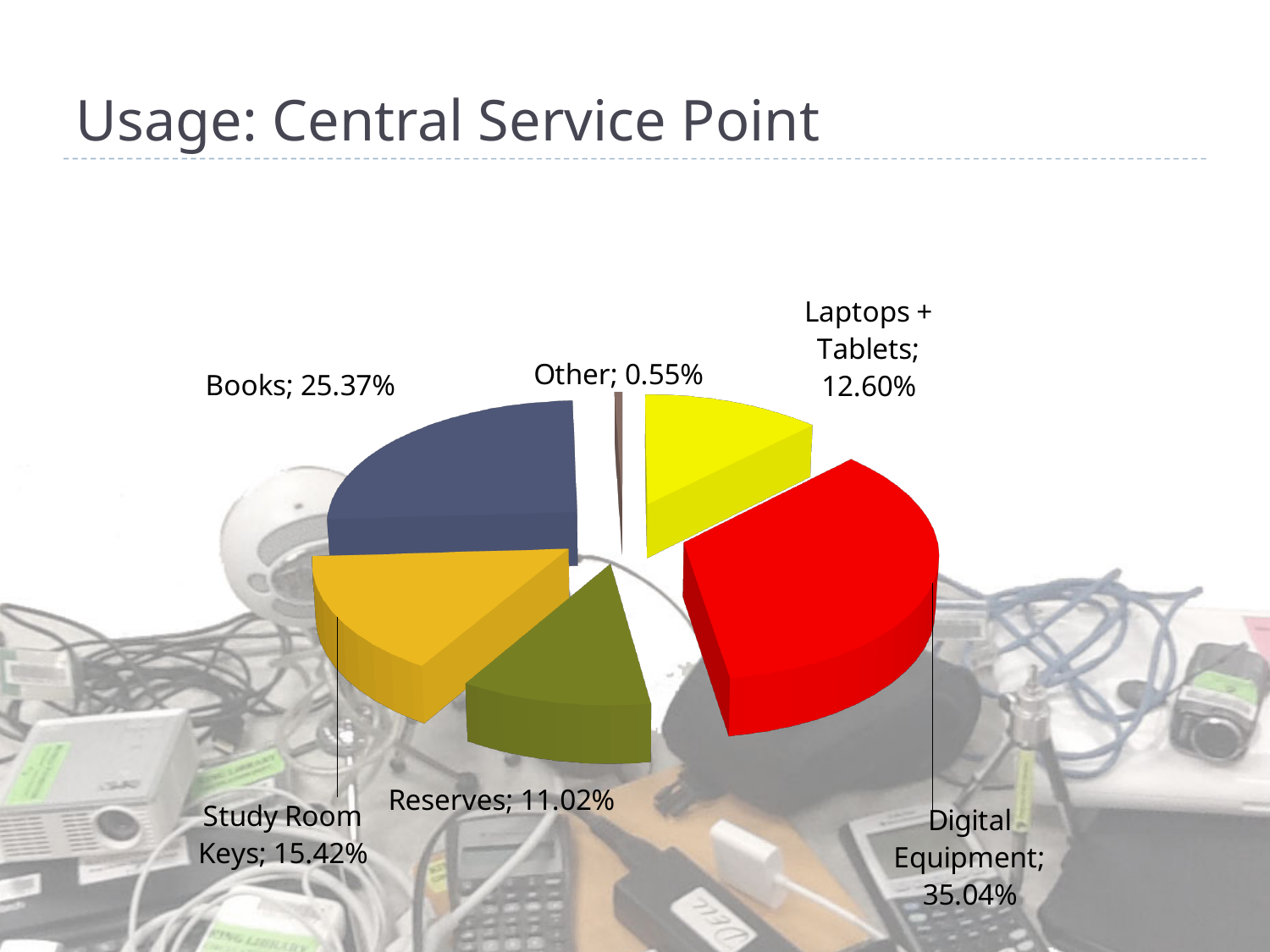
What is the share for Study Room Keys? 15.42% What type of chart is shown on the slide? pie chart Which category has the smallest share of the pie? Other Which is larger, the share for Books or the share for Study Room Keys? Books What is the title of the slide containing the chart? Usage: Central Service Point What is the share for Laptops + Tablets? 12.60% How many slices does the pie chart have? 6 What is the share for Reserves? 11.02% Which category has the largest share of the pie? Digital Equipment What is the difference in percentage points between Digital Equipment and Books? 9.67 What is the share for Digital Equipment? 35.04% What is the share for Books? 25.37%